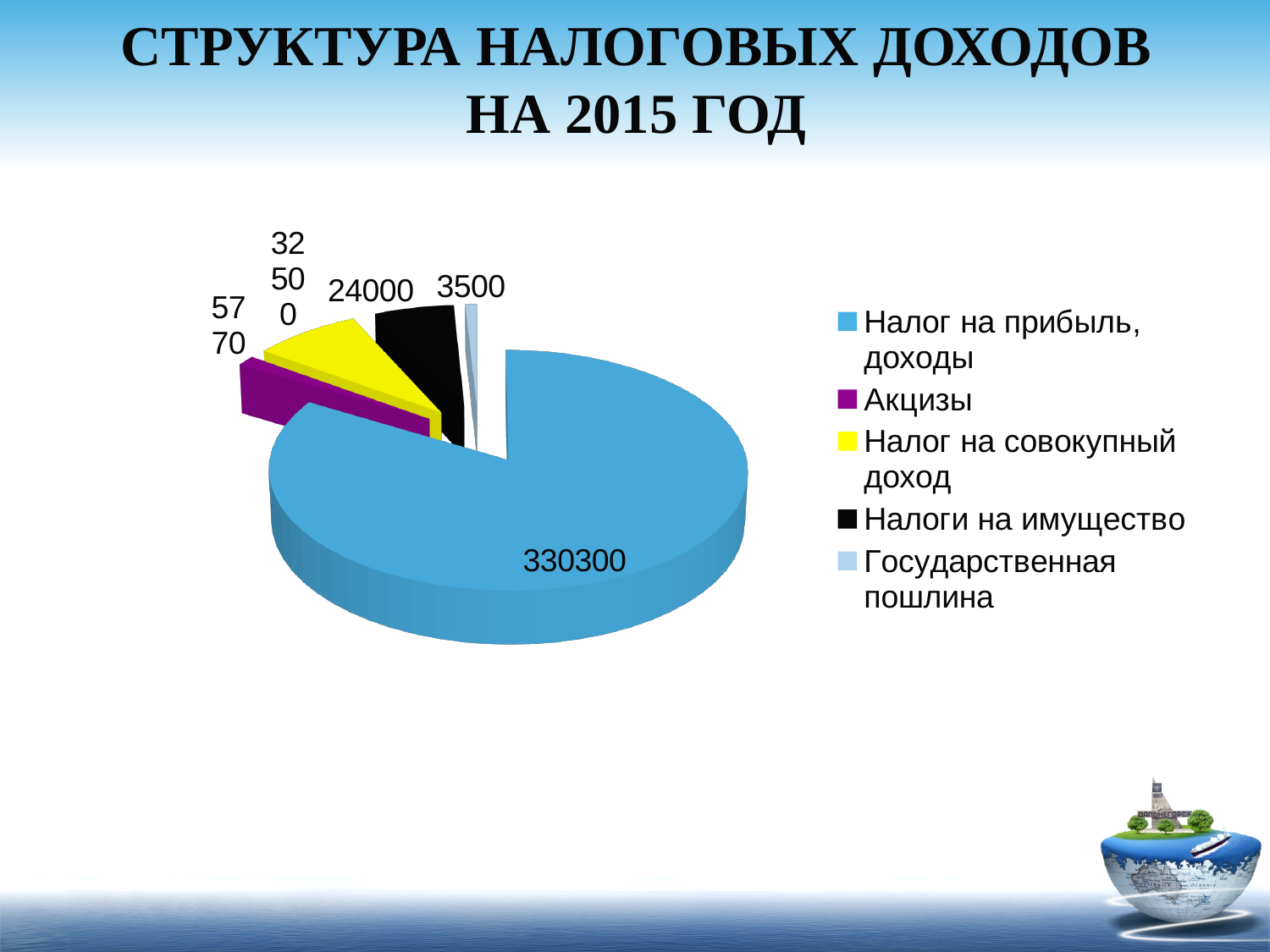
How many entries does the legend list? 5 What is the value for Налог на прибыль, доходы? 330300 Which category has the smallest slice of the pie? Государственная пошлина What is the difference between the values for Налоги на имущество and Государственная пошлина? 20500 How many slices does the pie chart have? 5 What is the value for Налоги на имущество? 24000 What colour is the slice for Акцизы? purple What is the value for Государственная пошлина? 3500 What is the value for Налог на совокупный доход? 32500 Which category has the largest slice of the pie? Налог на прибыль, доходы Which is larger, Налоги на имущество or Государственная пошлина? Налоги на имущество What kind of chart is shown on the slide? pie chart